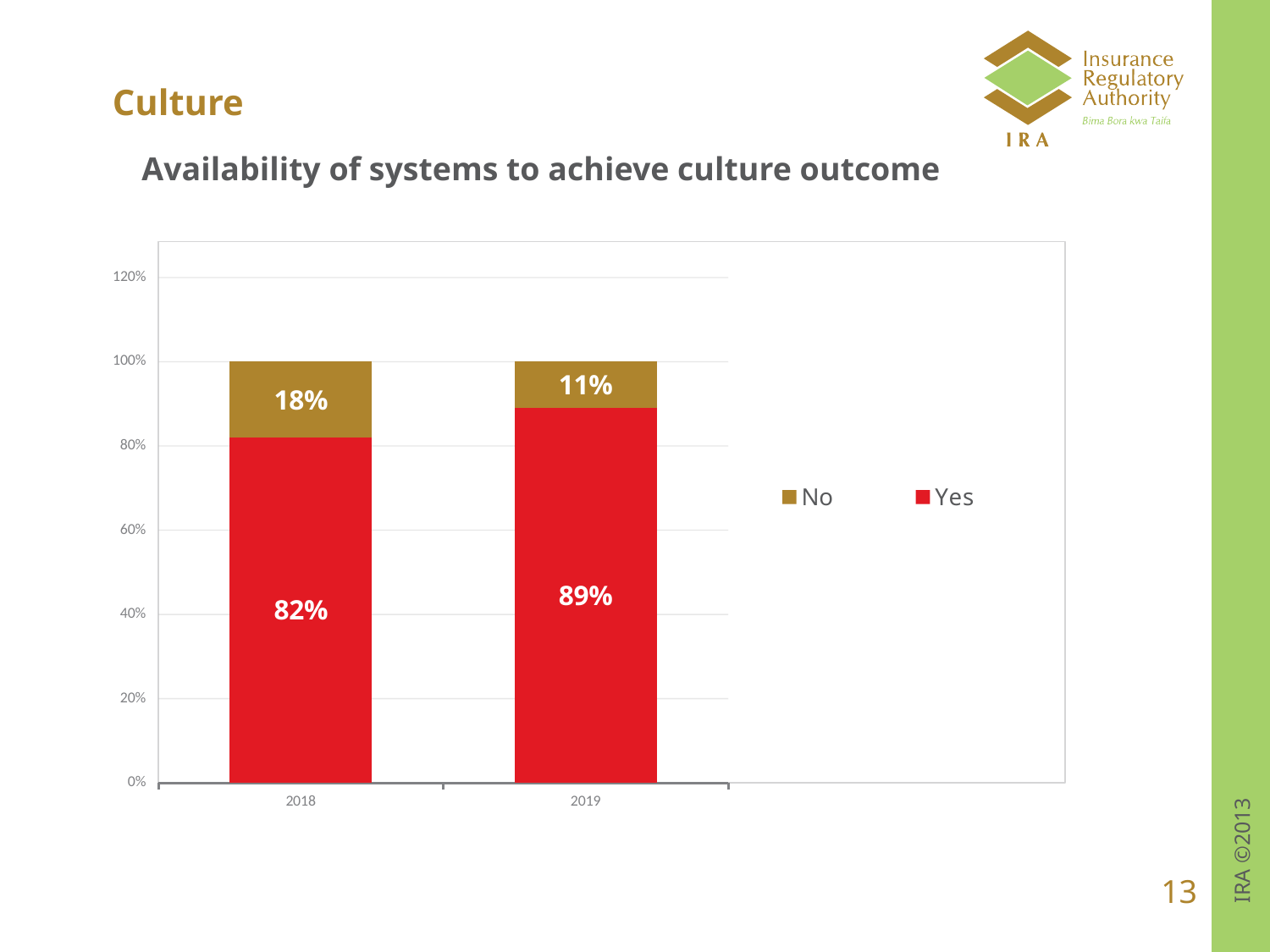
What is the total of the stacked bar for 2018? 100% How many years are shown on the x axis? 2 What is the value for Yes in 2019? 89% Which year has the higher value for Yes? 2019 Is the value for No in 2018 larger or smaller than the value for No in 2019? larger What is the difference between the Yes values for 2019 and 2018? 7% Which year has the lower value for No? 2019 What is the value for No in 2019? 11% What is the value for Yes in 2018? 82% What kind of chart is shown on the slide? Stacked bar chart What is the value for No in 2018? 18% How many series does the legend list? 2